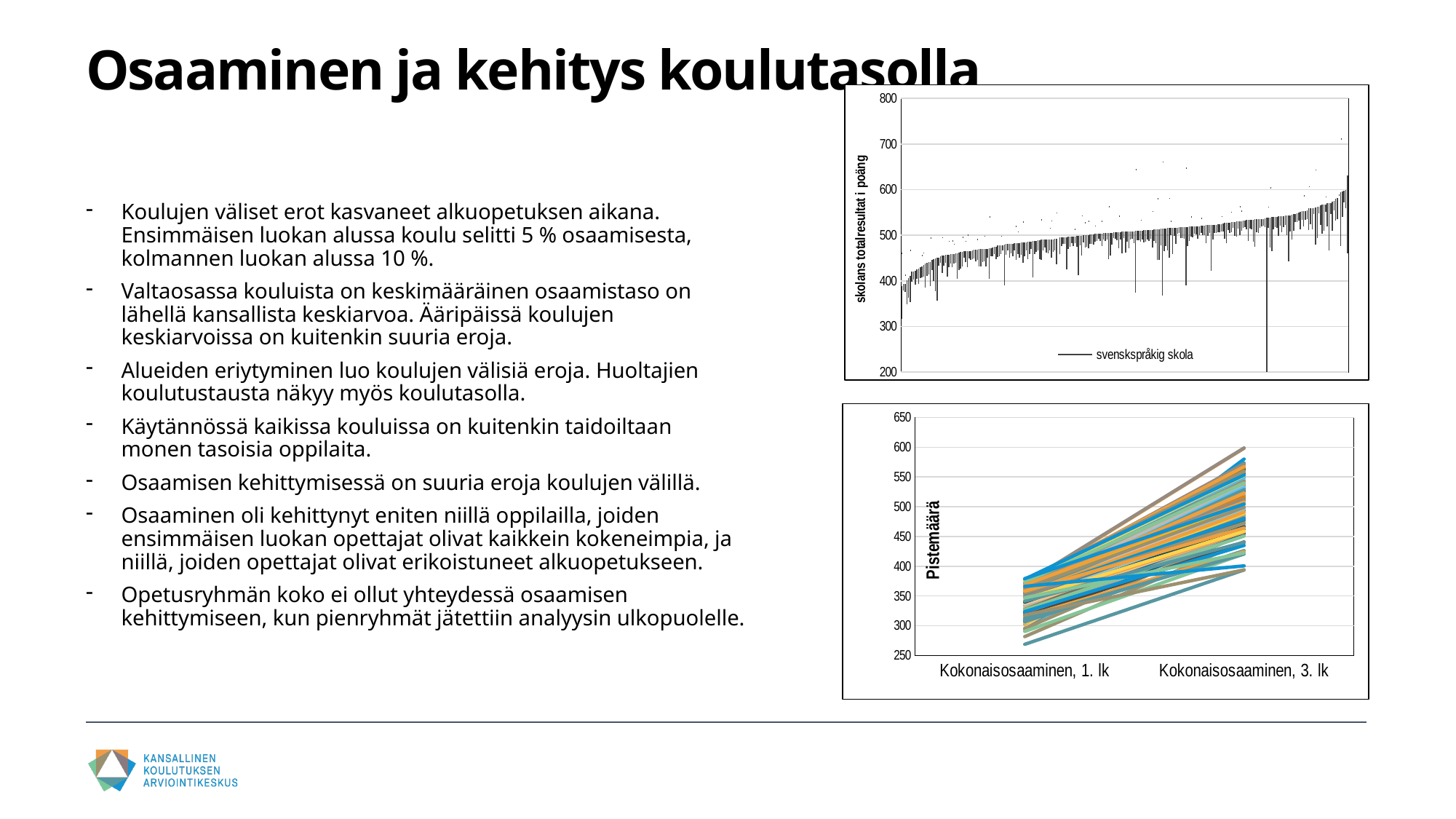
What is the y-axis label of the bottom chart? Pistemäärä What kind of chart is the bottom chart? line chart What is the minimum value shown on the y axis of the bottom chart? 250 What is the maximum value shown on the y axis of the top chart? 800 How many categories are shown on the x axis of the bottom chart? 2 In the bottom chart, is the highest value at Kokonaisosaaminen, 3. lk greater or less than 550? greater In the bottom chart, are the values at Kokonaisosaaminen, 1. lk greater or less than 400? less In the top chart, is the highest school total result greater or less than 600? greater In the bottom chart, do the lines generally rise or fall from Kokonaisosaaminen, 1. lk to Kokonaisosaaminen, 3. lk? rise